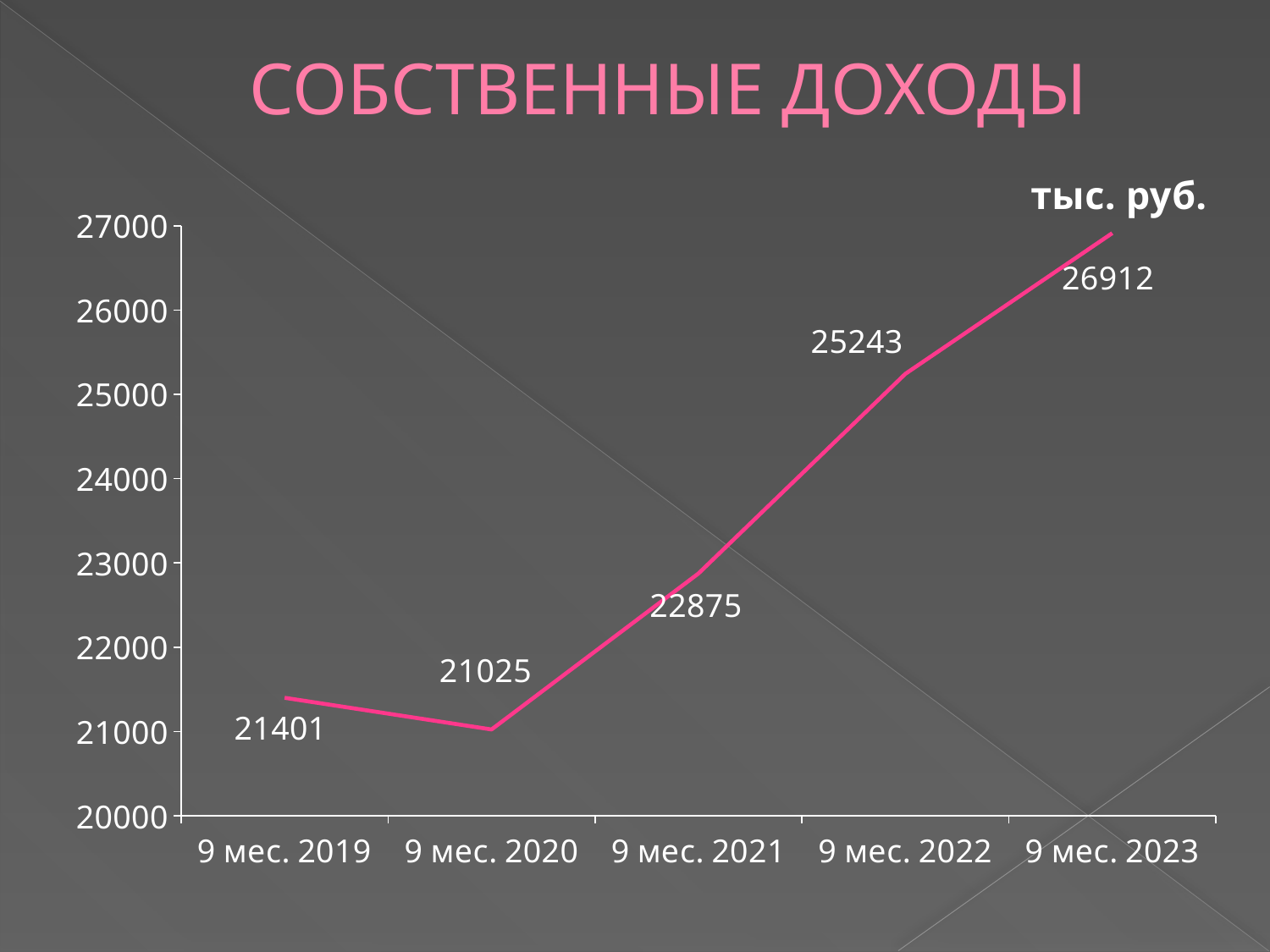
What is the title of the chart? СОБСТВЕННЫЕ ДОХОДЫ Which is larger, the value for 9 мес. 2021 or the value for 9 мес. 2020? 9 мес. 2021 What kind of chart is shown on the slide? line chart What is the value for 9 мес. 2021? 22875 What is the difference between the values for 9 мес. 2023 and 9 мес. 2022? 1669 Which period has the highest value? 9 мес. 2023 What is the value for 9 мес. 2023? 26912 Which period has the lowest value? 9 мес. 2020 How many periods are plotted on the x axis? 5 What is the difference between the values for 9 мес. 2019 and 9 мес. 2020? 376 Is the value for 9 мес. 2022 greater or less than 25000? greater What is the value for 9 мес. 2019? 21401